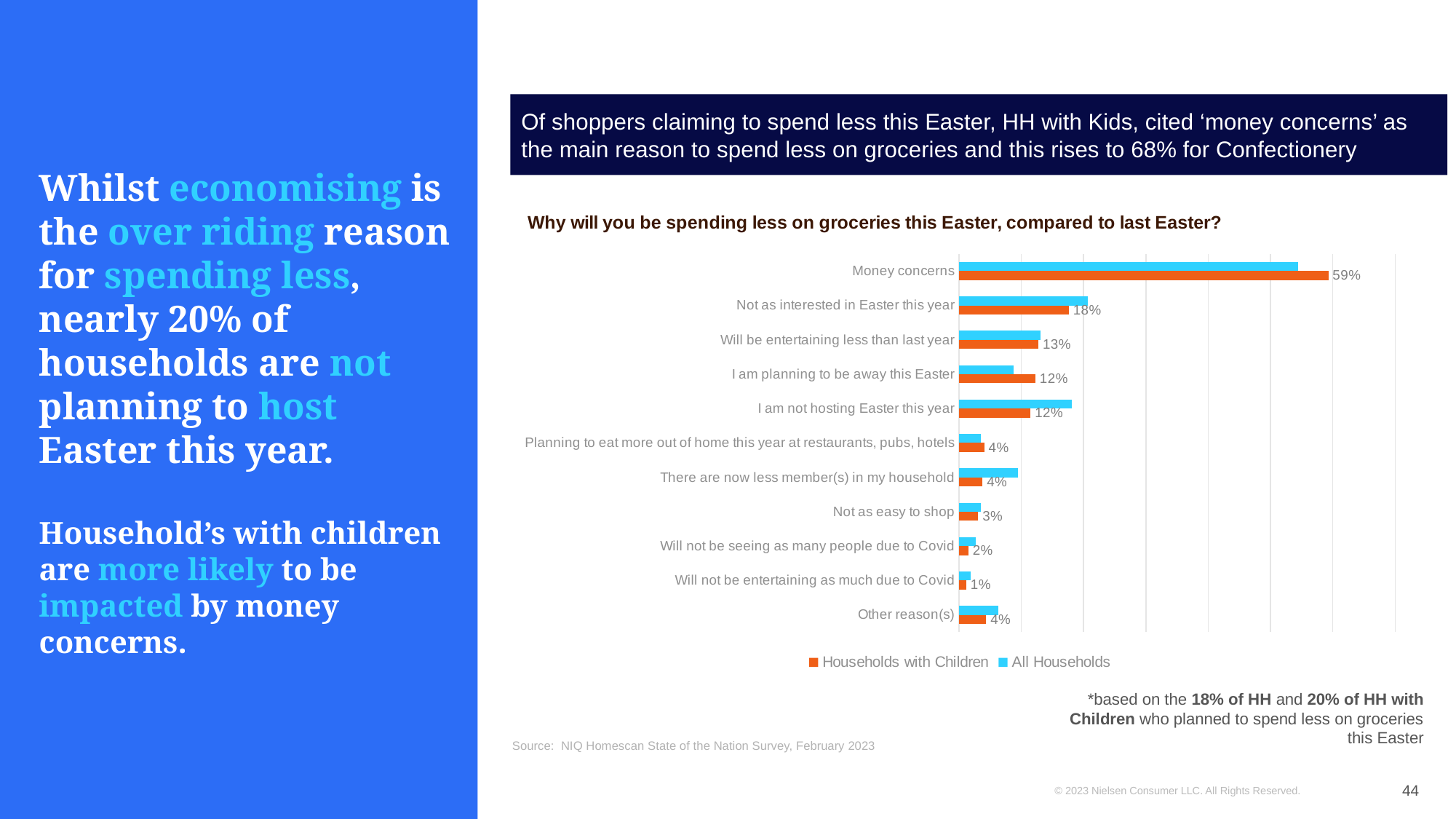
Which reason has the lowest value for Households with Children? Will not be entertaining as much due to Covid For Households with Children, what is the difference between 'Not as interested in Easter this year' and 'Will be entertaining less than last year'? 5% How many series does the chart legend list? 2 For Households with Children, what is the difference between 'Money concerns' and 'Not as interested in Easter this year'? 41% What percentage of Households with Children cited 'Money concerns' as the reason for spending less on groceries this Easter? 59% For Households with Children, which is larger: 'Will be entertaining less than last year' or 'I am planning to be away this Easter'? Will be entertaining less than last year What is the value for 'Will not be entertaining as much due to Covid' for Households with Children? 1% How many reasons (categories) are shown in the chart? 11 What type of chart is used to show the reasons for spending less on groceries? Bar chart What is the value for 'Will be entertaining less than last year' for Households with Children? 13% What is the value for 'Not as interested in Easter this year' for Households with Children? 18% Which reason has the highest value for Households with Children? Money concerns